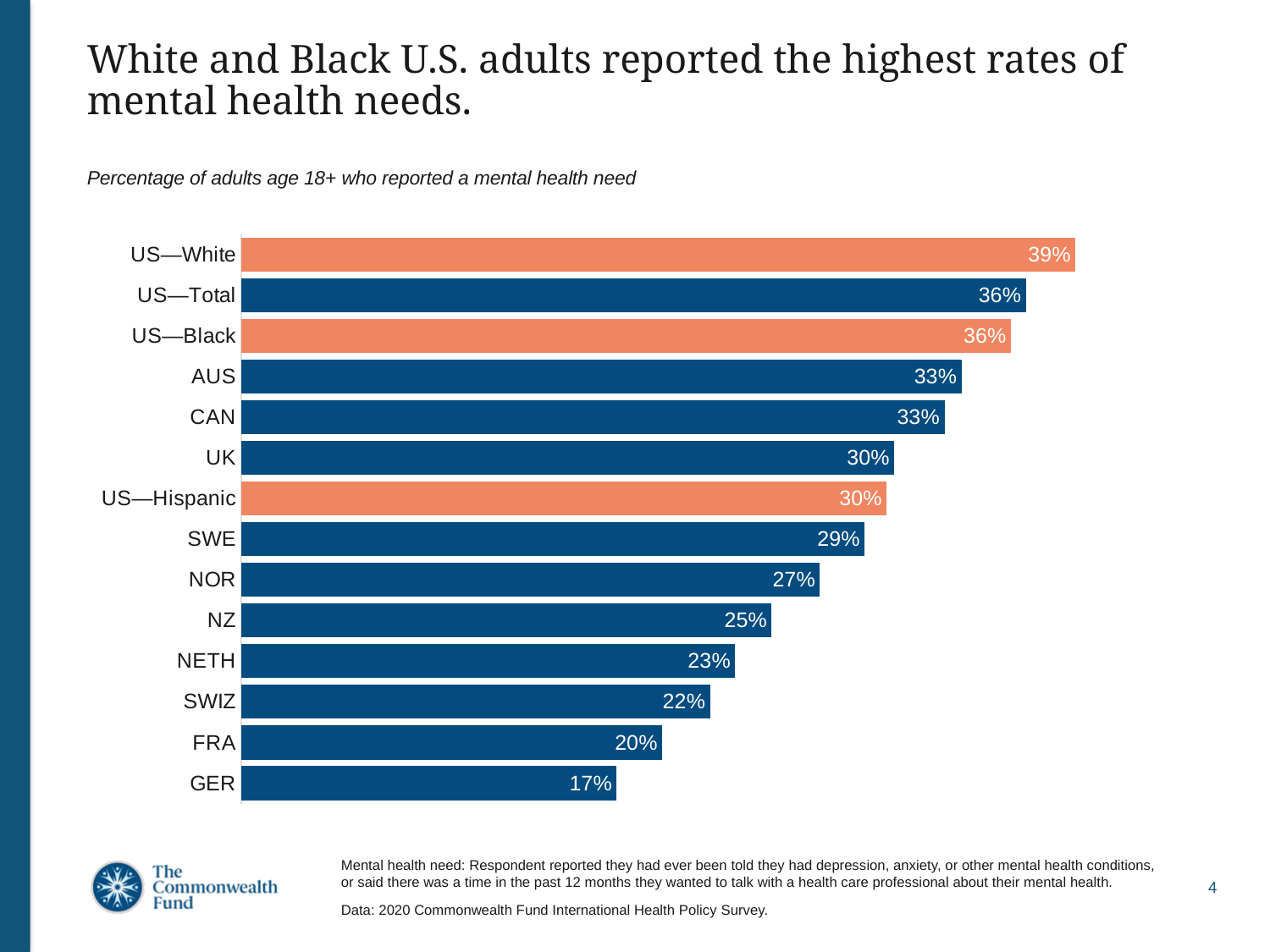
Which category has the lowest percentage of adults reporting a mental health need? GER Which has a higher value, SWE or NZ? SWE What type of chart is shown on the slide? Bar chart How many categories are shown in the chart? 14 What is the difference in percentage points between US—Total and US—Hispanic? 6 Which category has the highest percentage of adults reporting a mental health need? US—White Which has a higher value, FRA or NETH? NETH What is the difference in percentage points between US—White and GER? 22 What is the value shown for GER? 17% What percentage is shown for US—Hispanic? 30% What percentage of US—White adults reported a mental health need? 39% Which bars are coloured orange rather than blue? US—White, US—Black, US—Hispanic